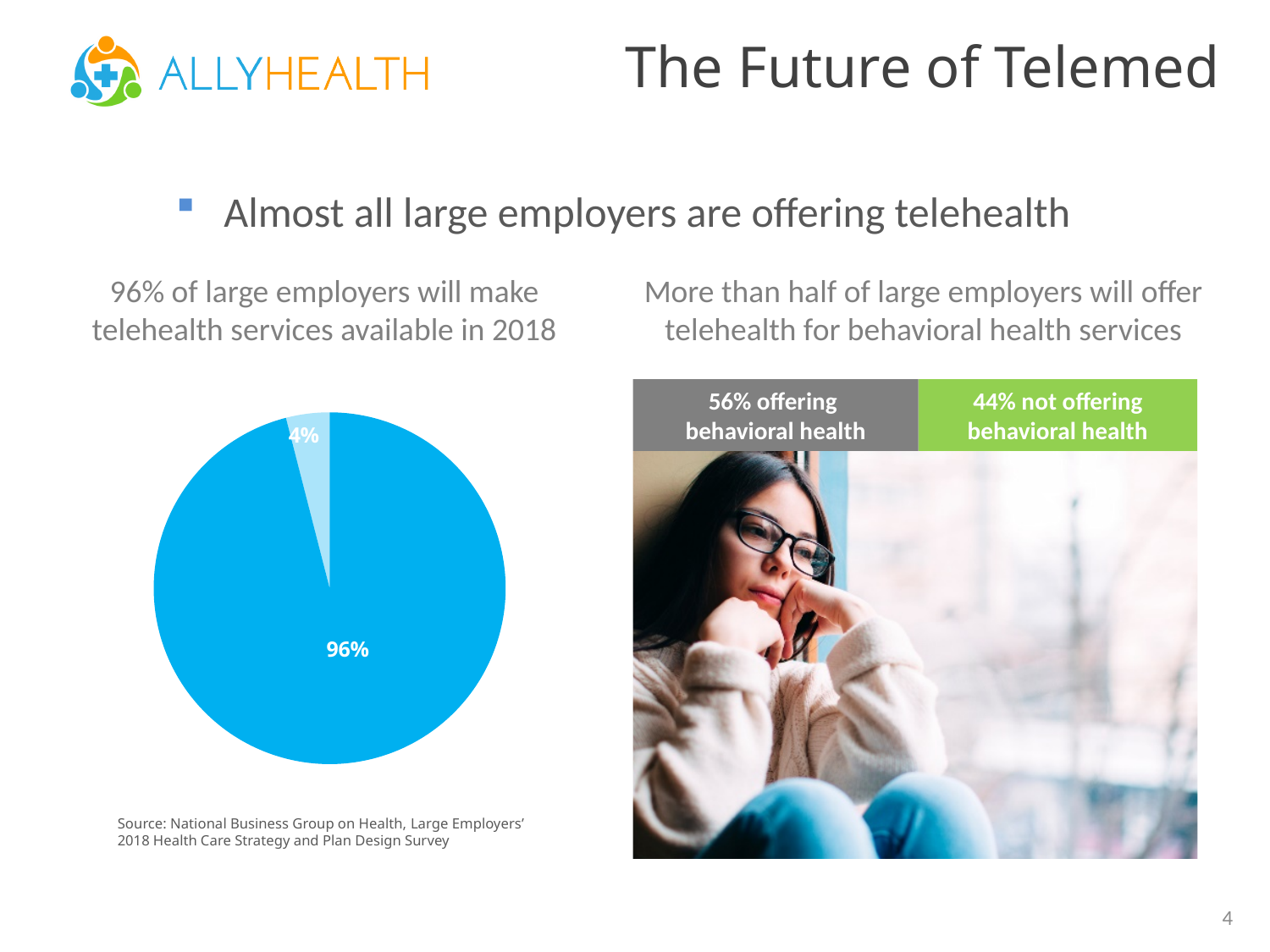
In the bar graphic on the right, what percentage of large employers are offering behavioral health telehealth? 56% In the bar graphic on the right, what percentage of large employers are not offering behavioral health telehealth? 44% How many slices does the pie chart on the left have? 2 What kind of chart is shown on the left side of the slide? pie chart What colour is the largest slice of the pie chart? blue What is the value of the largest slice in the pie chart? 96% What share of the pie chart does the dark blue slice represent? 96% According to the text above the pie chart, what does the 96% slice represent? Large employers that will make telehealth services available in 2018 What is the value of the smallest slice in the pie chart? 4% In the pie chart, what is the difference between the larger slice and the smaller slice? 92% In the pie chart, which slice is larger: the one labelled 96% or the one labelled 4%? 96% What do the two slices of the pie chart add up to? 100%